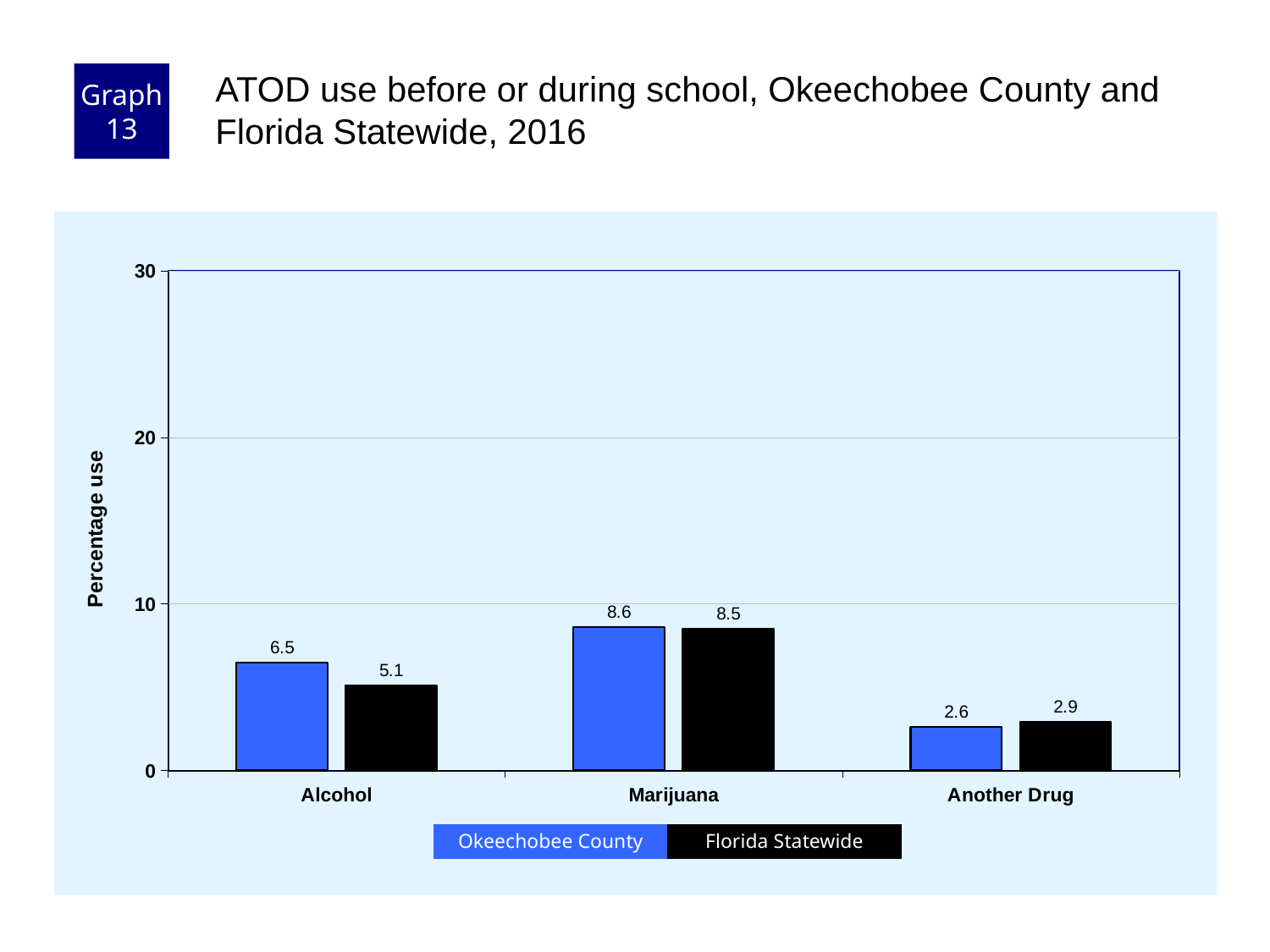
What is the Okeechobee County value for Alcohol? 6.5 How many categories are shown on the x axis? 3 Which category has the lowest Florida Statewide value? Another Drug How many series does the legend list? 2 What kind of chart is shown? bar chart What is the difference between the Okeechobee County and Florida Statewide values for Alcohol? 1.4 What is the Okeechobee County value for Another Drug? 2.6 What is the Florida Statewide value for Marijuana? 8.5 Is the Okeechobee County value for Marijuana greater or less than 10? less For Another Drug, which is larger: Okeechobee County or Florida Statewide? Florida Statewide What is the label of the y axis? Percentage use Which category has the highest Okeechobee County value? Marijuana